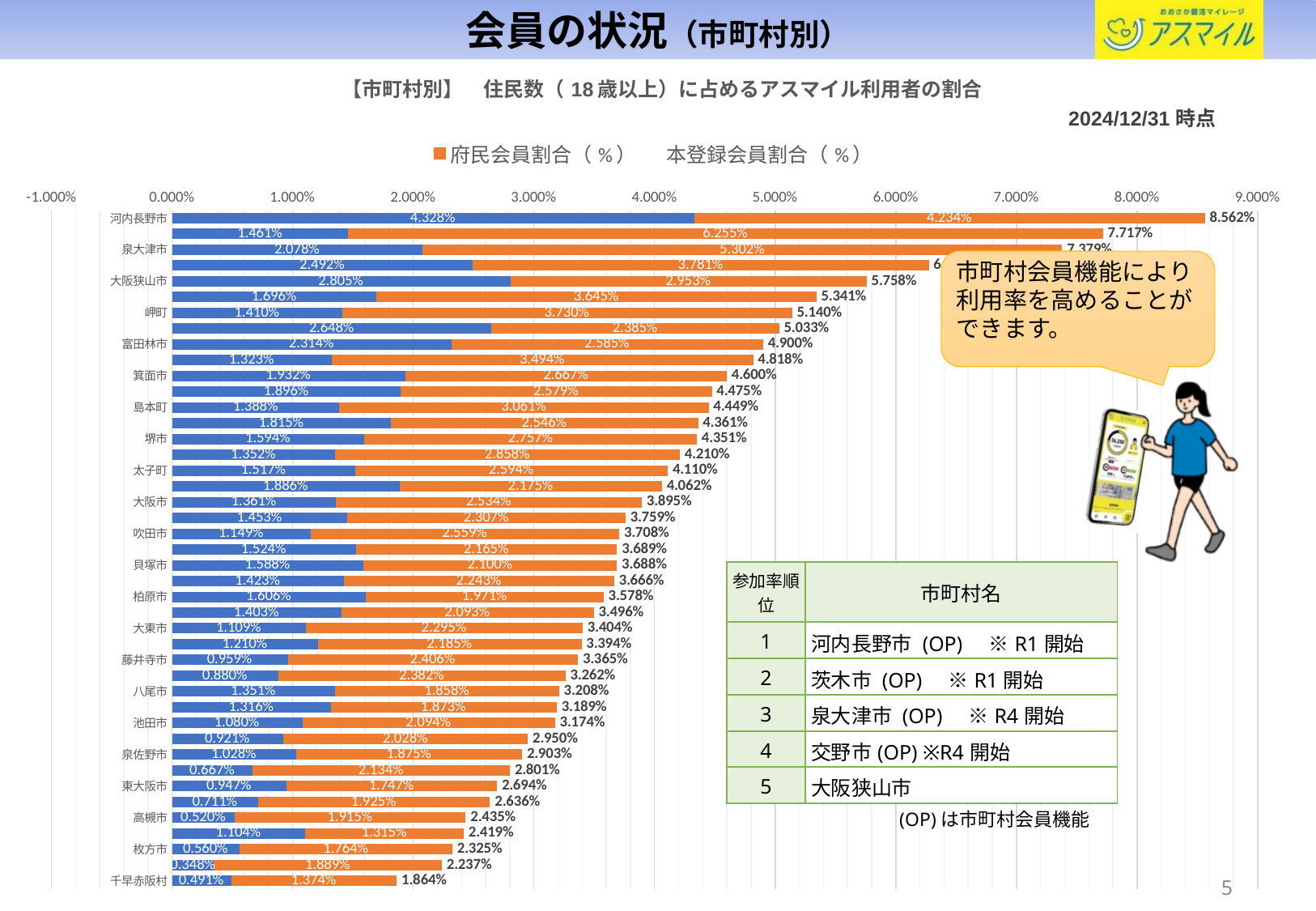
Is the total value for 千早赤阪村 greater or less than 2.000%? less What is the difference between the 府民会員割合 and 本登録会員割合 values for 河内長野市? 4.328% What is the total value labelled for 堺市? 4.351% Do the total bar values rise or fall going from the top of the chart to the bottom? fall What kind of chart is shown on the slide? bar chart What is the total value labelled at the end of the bar for 河内長野市? 8.562% Which municipality has the lowest total bar in the chart? 千早赤阪村 What is the 本登録会員割合 value for 岬町? 5.140% Which municipality has the highest total bar in the chart? 河内長野市 Which has the larger total value, 泉大津市 or 大阪狭山市? 泉大津市 What is the 府民会員割合 value for 大阪狭山市? 2.953% How many series does the chart legend list? 2